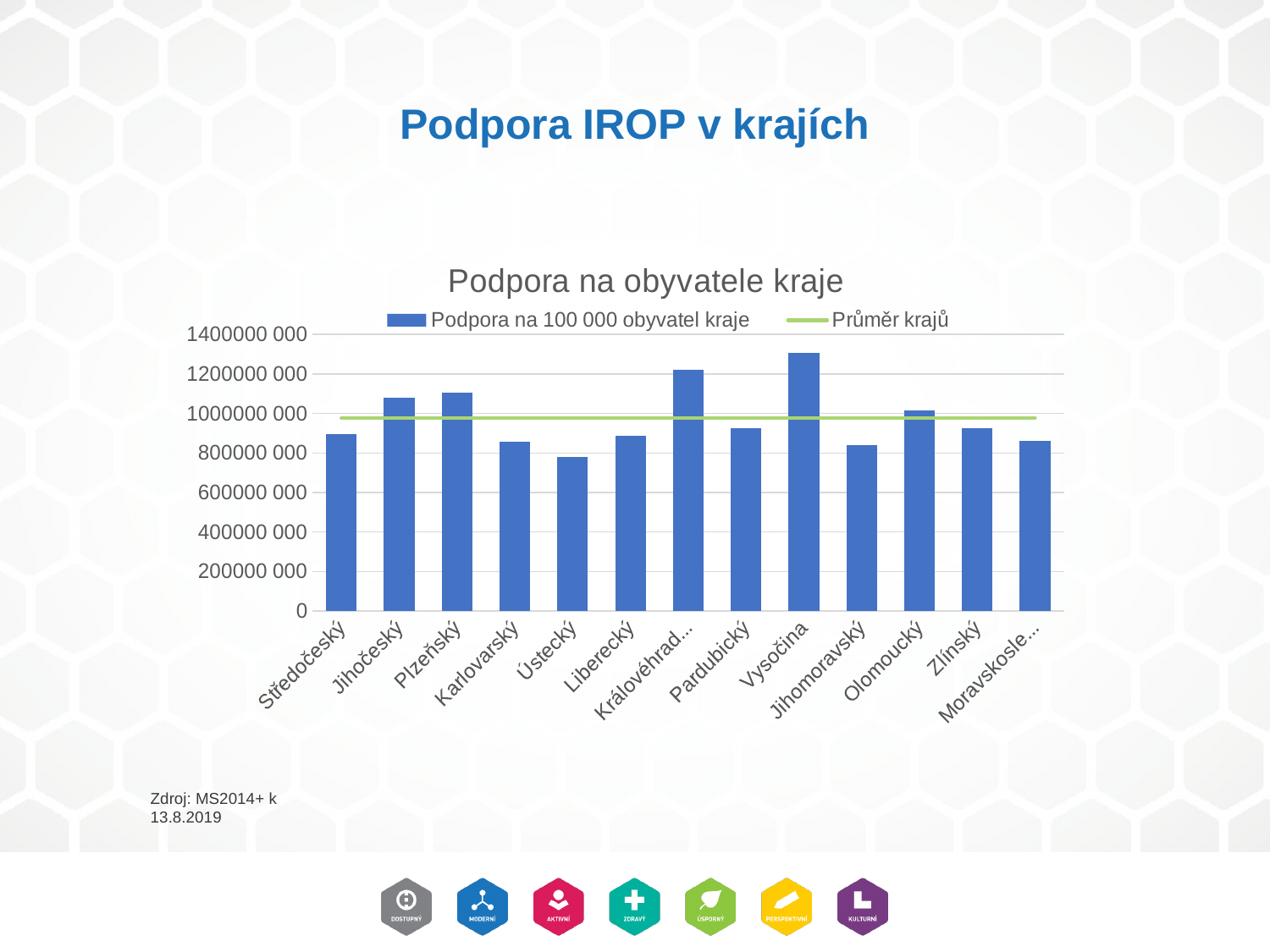
Is the value for Vysočina greater or less than 1200000 000? greater Which region has the highest value for Podpora na 100 000 obyvatel kraje? Vysočina How many regions (categories) are shown on the x axis? 13 What is the title of the chart? Podpora na obyvatele kraje Which has the larger value, Plzeňský or Karlovarský? Plzeňský What kind of chart is shown on the slide? combination bar and line chart How many series does the legend list? 2 Which region has the lowest value for Podpora na 100 000 obyvatel kraje? Ústecký Is the value for Jihočeský greater or less than 1000000 000? greater Is the value for Jihomoravský greater or less than 1000000 000? less What is the name of the line series shown in the legend? Průměr krajů